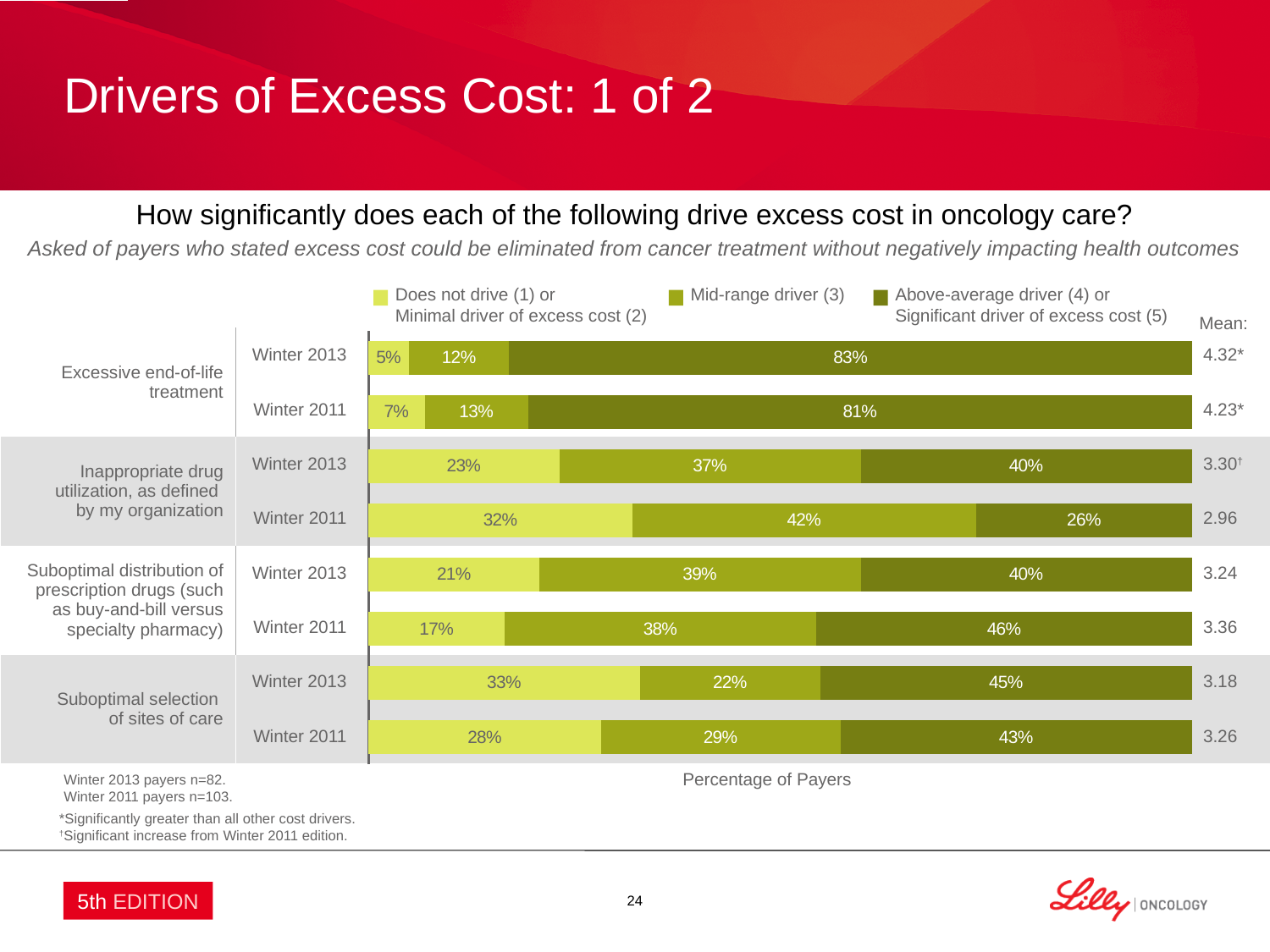
For suboptimal selection of sites of care, is the Winter 2013 or Winter 2011 share of 'does not drive or minimal driver' responses larger? Winter 2013 What is the mean score for suboptimal selection of sites of care in Winter 2013? 3.18 How many bars are plotted in the chart? 8 Which cost driver has the lowest share of above-average or significant driver responses in Winter 2011? Inappropriate drug utilization, as defined by my organization What is the total of the three segments in the Winter 2011 bar for suboptimal distribution of prescription drugs? 101% What is the difference between the Winter 2013 and Winter 2011 above-average or significant driver percentages for inappropriate drug utilization? 14 percentage points What kind of chart is shown on the slide? Stacked bar chart How many series does the legend list? 3 What percentage of payers in Winter 2011 rated inappropriate drug utilization as a mid-range driver? 42% Which cost driver has the highest share of above-average or significant driver responses in Winter 2013? Excessive end-of-life treatment What is the label on the x axis of the chart? Percentage of Payers What percentage of payers in Winter 2013 rated excessive end-of-life treatment as an above-average or significant driver of excess cost? 83%